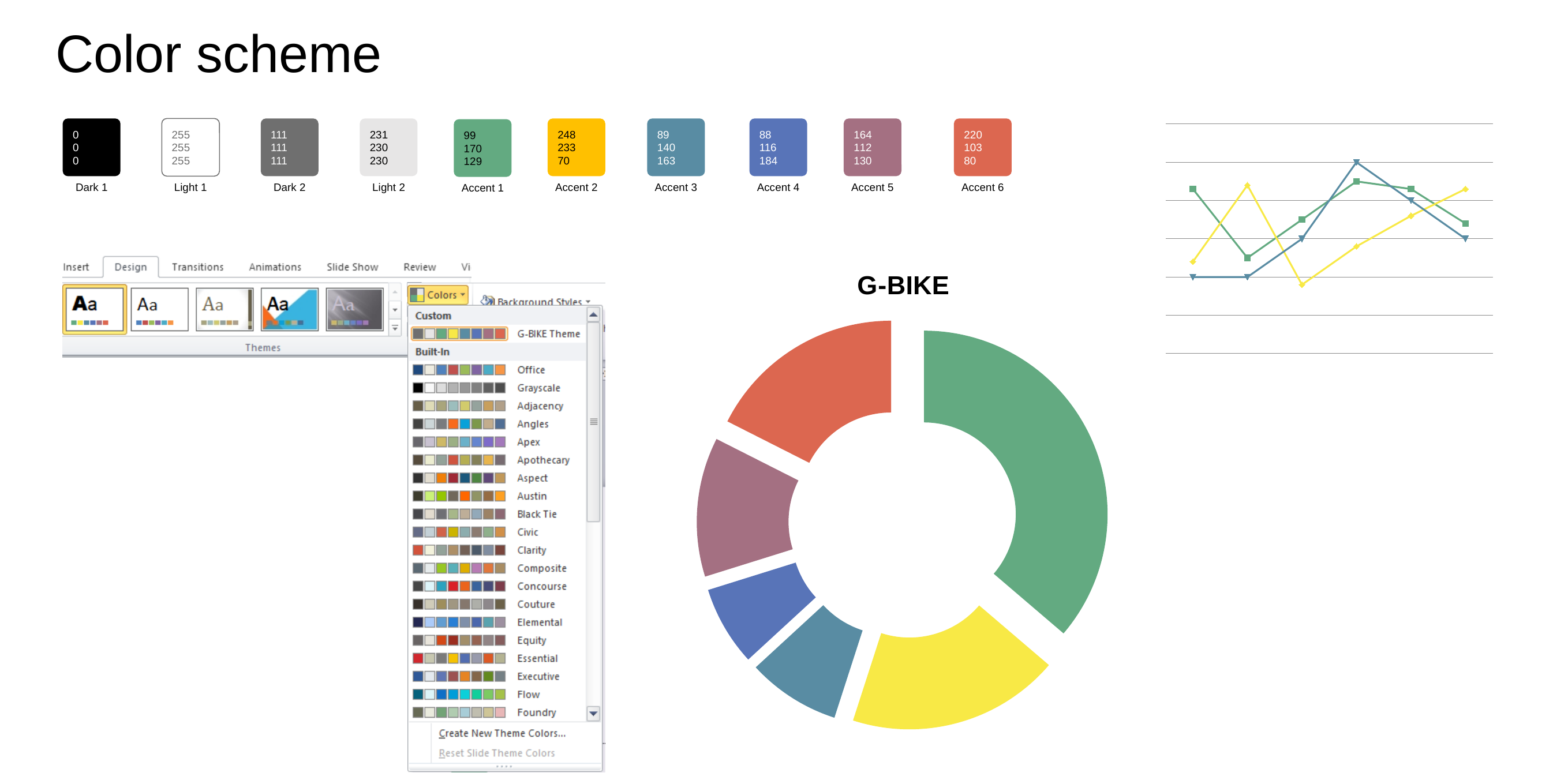
In the G-BIKE doughnut chart, which colour slice is the largest? green What colours are the three lines in the top-right line chart? green, blue and yellow In the top-right line chart, which line has the highest value at the fourth point on the x axis? blue What kind of chart is shown at the top right of the slide? line chart In the top-right line chart, which line has the highest value at the last point on the x axis? yellow How many slices does the G-BIKE doughnut chart have? 6 How many data points does each line in the top-right line chart have? 6 What kind of chart is the G-BIKE chart? doughnut chart In the G-BIKE doughnut chart, which is larger, the green slice or the yellow slice? green How many lines are plotted in the line chart at the top right of the slide? 3 What is the title of the doughnut chart in the middle of the slide? G-BIKE